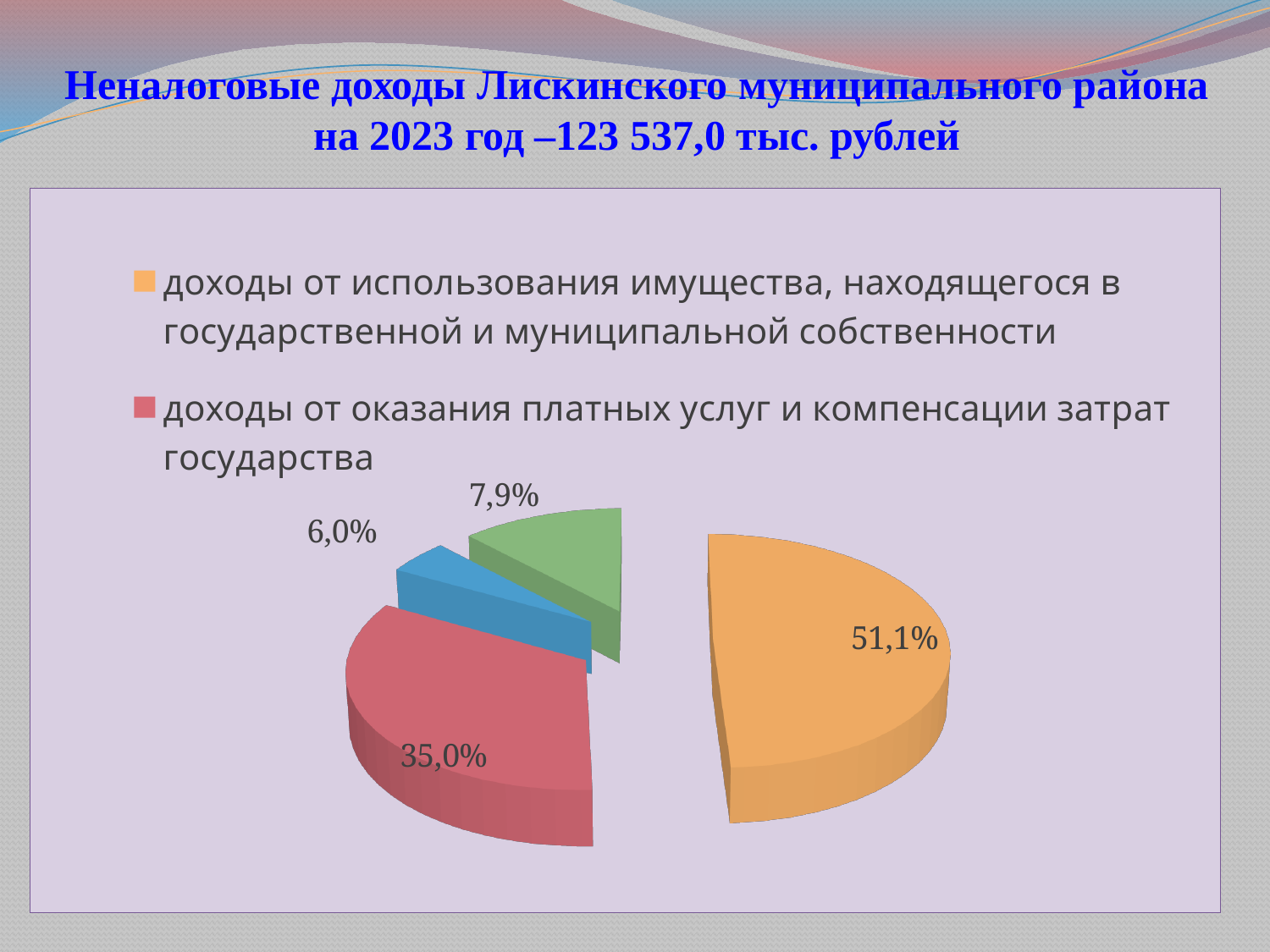
Which is larger: the slice for доходы от оказания платных услуг и компенсации затрат государства or the slice for доходы от использования имущества, находящегося в государственной и муниципальной собственности? доходы от использования имущества, находящегося в государственной и муниципальной собственности What is the difference in percentage points between the slice labelled 51,1% and the slice labelled 35,0%? 16,1 What share of the pie is labelled for доходы от использования имущества, находящегося в государственной и муниципальной собственности? 51,1% Which legend category has the largest slice of the pie? доходы от использования имущества, находящегося в государственной и муниципальной собственности What kind of chart is shown on the slide? pie chart How many entries does the legend list? 2 What share of the pie is labelled for доходы от оказания платных услуг и компенсации затрат государства? 35,0% What is the largest percentage value printed on the pie chart? 51,1% What percentage is printed on the green slice of the pie? 7,9% How many slices does the pie chart have? 4 What is the smallest percentage value printed on the pie chart? 6,0% What colour is the slice for доходы от оказания платных услуг и компенсации затрат государства? red